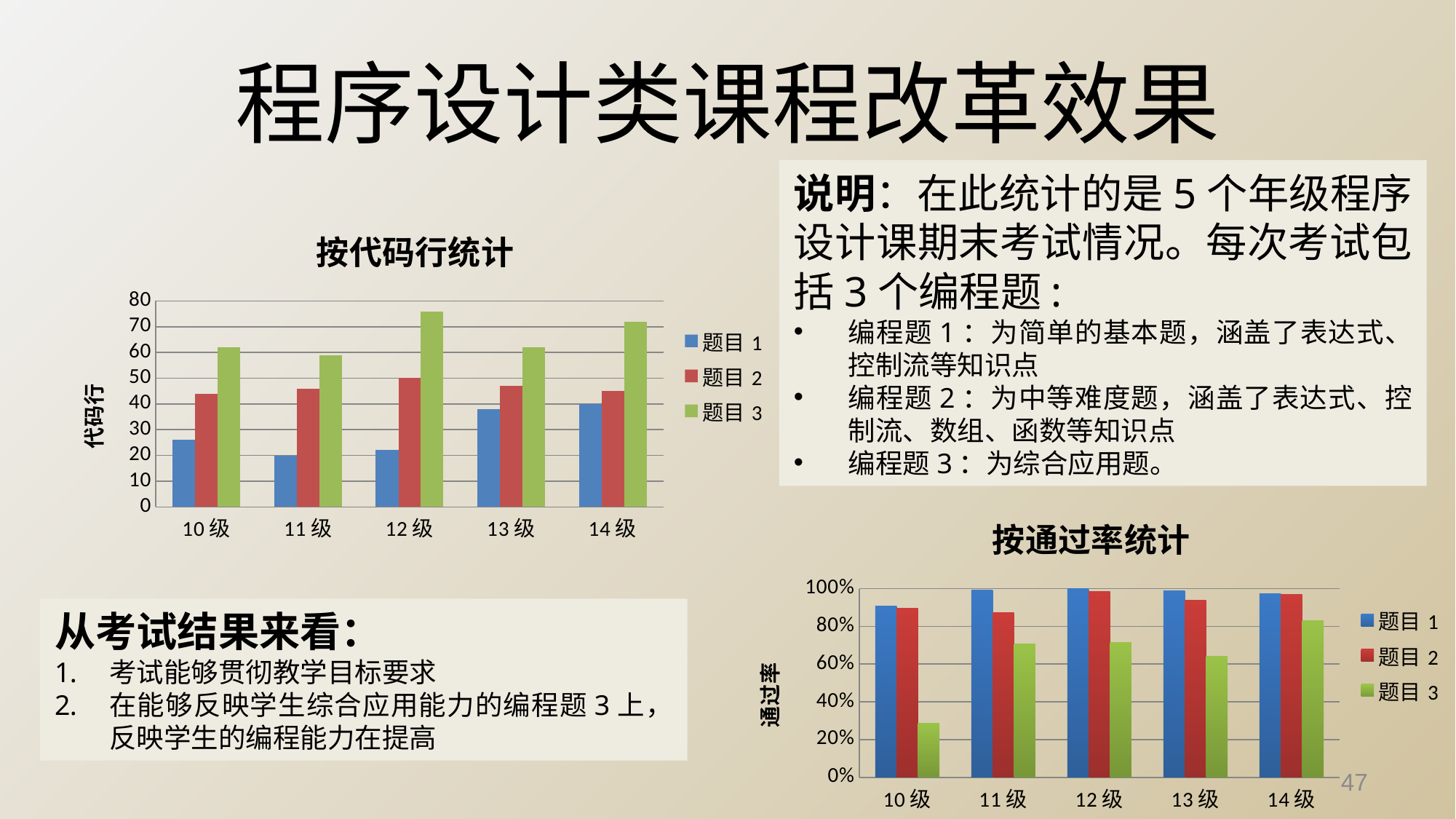
In the '按代码行统计' chart, at 10 级, which is larger: 题目 2 or 题目 3? 题目 3 How many series does the legend of the '按通过率统计' chart list? 3 What is the y-axis title of the '按代码行统计' chart? 代码行 In the '按代码行统计' chart, which grade has the highest value for 题目 3? 12 级 In the '按通过率统计' chart, at 14 级, which is larger: 题目 1 or 题目 3? 题目 1 In the '按通过率统计' chart, what is the pass rate for 题目 1 at 12 级? 100% What kind of chart is the '按代码行统计' chart? bar chart In the '按通过率统计' chart, which grade has the lowest pass rate for 题目 3? 10 级 How many grade categories are shown on the x axis of the '按代码行统计' chart? 5 In the '按代码行统计' chart, is the value for 题目 1 at 10 级 greater or less than 30? less In the '按通过率统计' chart, is the pass rate for 题目 3 at 13 级 greater or less than 80%? less In the '按代码行统计' chart, is the value for 题目 3 at 12 级 greater or less than 70? greater